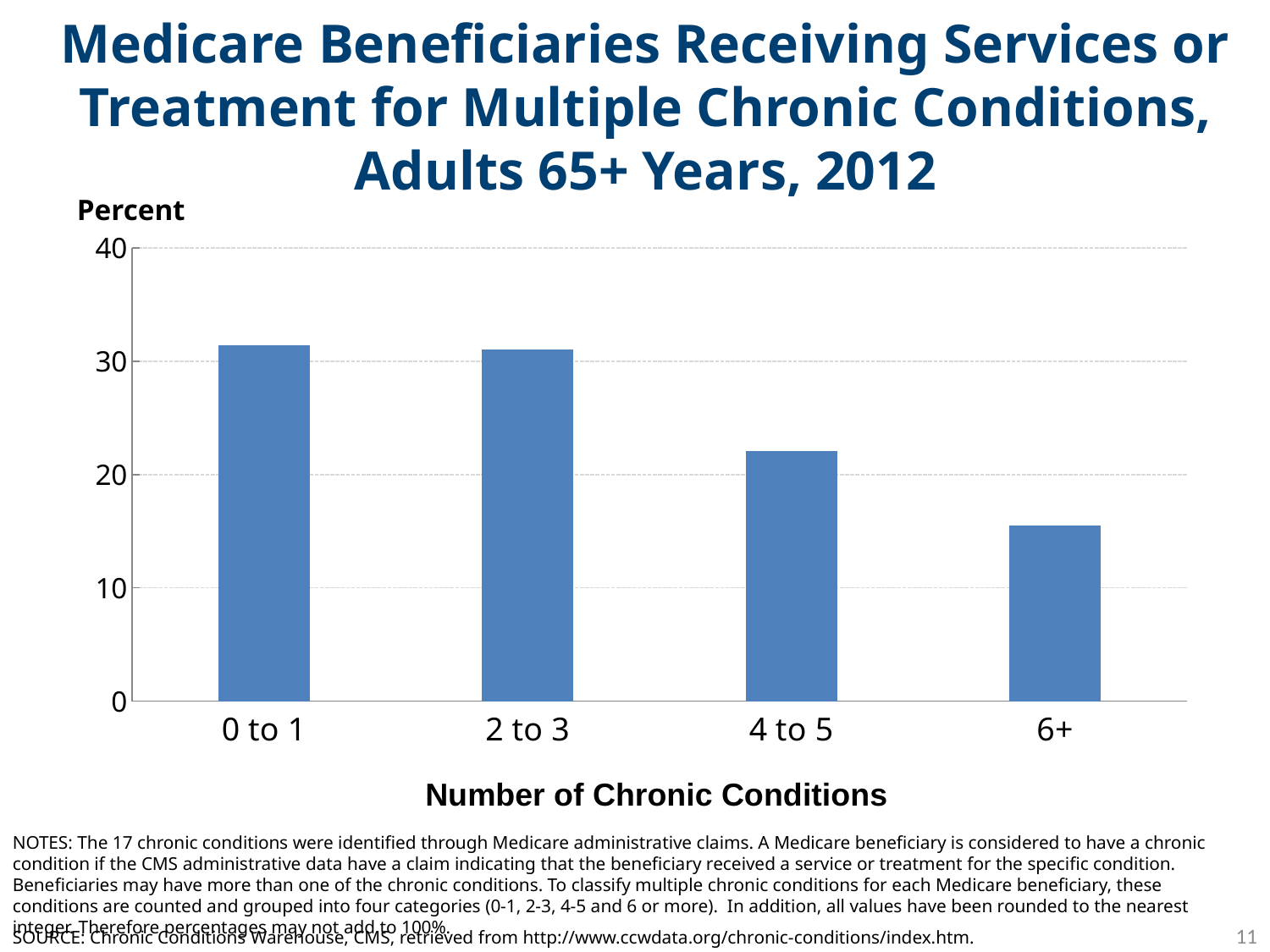
Is the value for 4 to 5 chronic conditions greater or less than 20? greater Is the value for 0 to 1 chronic conditions greater or less than 30? greater What is the title of the x axis? Number of Chronic Conditions Do the values rise or fall as the number of chronic conditions increases along the x axis? fall Which category has the lowest percentage of Medicare beneficiaries? 6+ Which is larger, the value for 4 to 5 chronic conditions or the value for 6+ chronic conditions? 4 to 5 What kind of chart is shown on the slide? bar chart Is the value for 6+ chronic conditions greater or less than 10? greater How many categories of chronic conditions are shown on the x axis? 4 Which is larger, the value for 0 to 1 chronic conditions or the value for 4 to 5 chronic conditions? 0 to 1